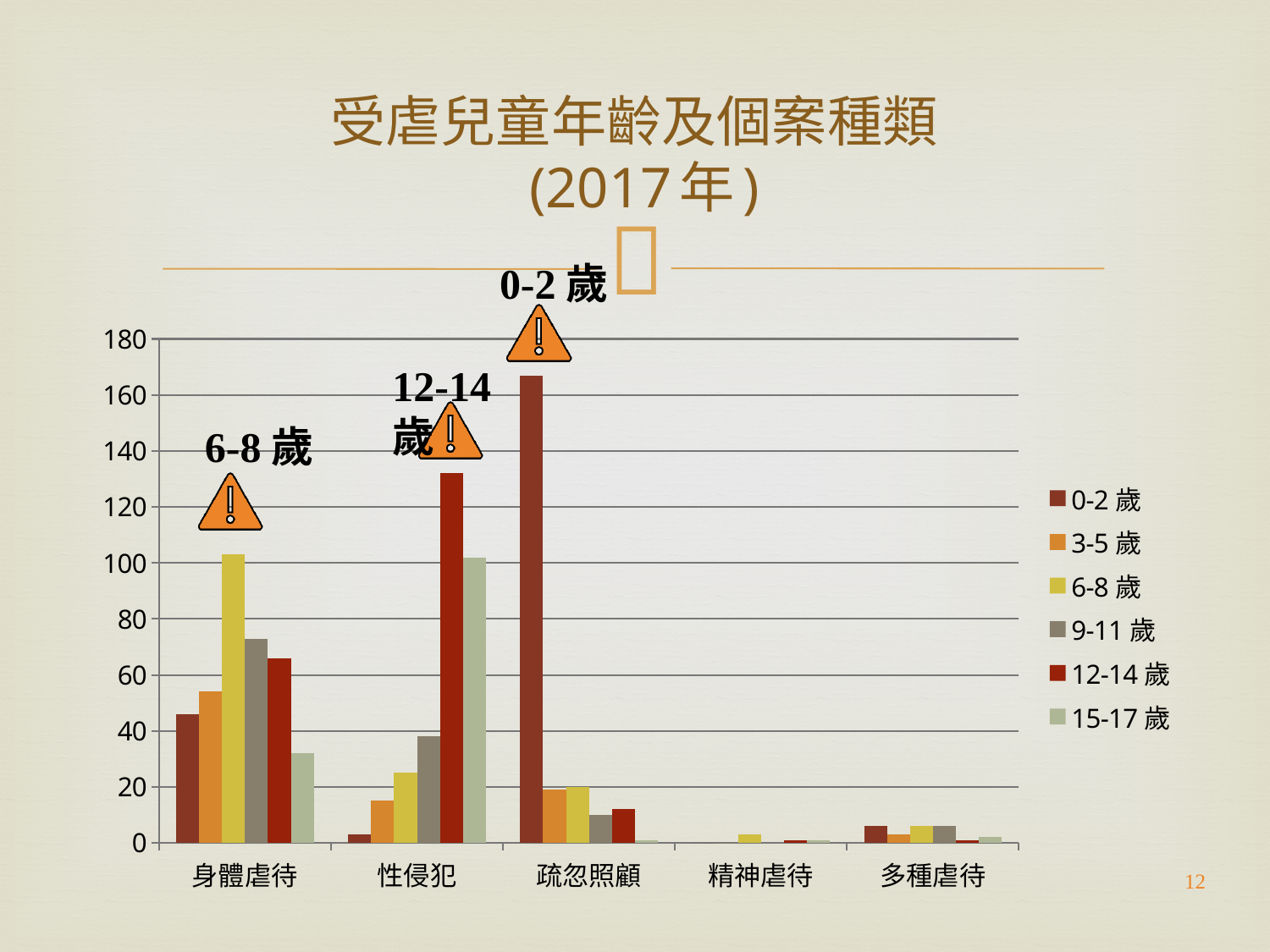
Which age group has the highest bar in the 疏忽照顧 category? 0-2 歲 Which age group has the highest bar in the 性侵犯 category? 12-14 歲 How many series does the chart's legend list? 6 What is the title of the chart on the slide? 受虐兒童年齡及個案種類(2017年) Which age group has the lowest bar in the 身體虐待 category? 15-17 歲 Is the value for 0-2 歲 in the 疏忽照顧 category greater or less than 160? greater How many categories are shown on the x axis of the chart? 5 Which age group has the highest bar in the 身體虐待 category? 6-8 歲 What kind of chart is shown on the slide? bar chart Is the value for 9-11 歲 in the 身體虐待 category greater or less than 60? greater Is the value for 12-14 歲 in the 性侵犯 category greater or less than 120? greater In the 性侵犯 category, which is larger: the bar for 12-14 歲 or the bar for 15-17 歲? 12-14 歲